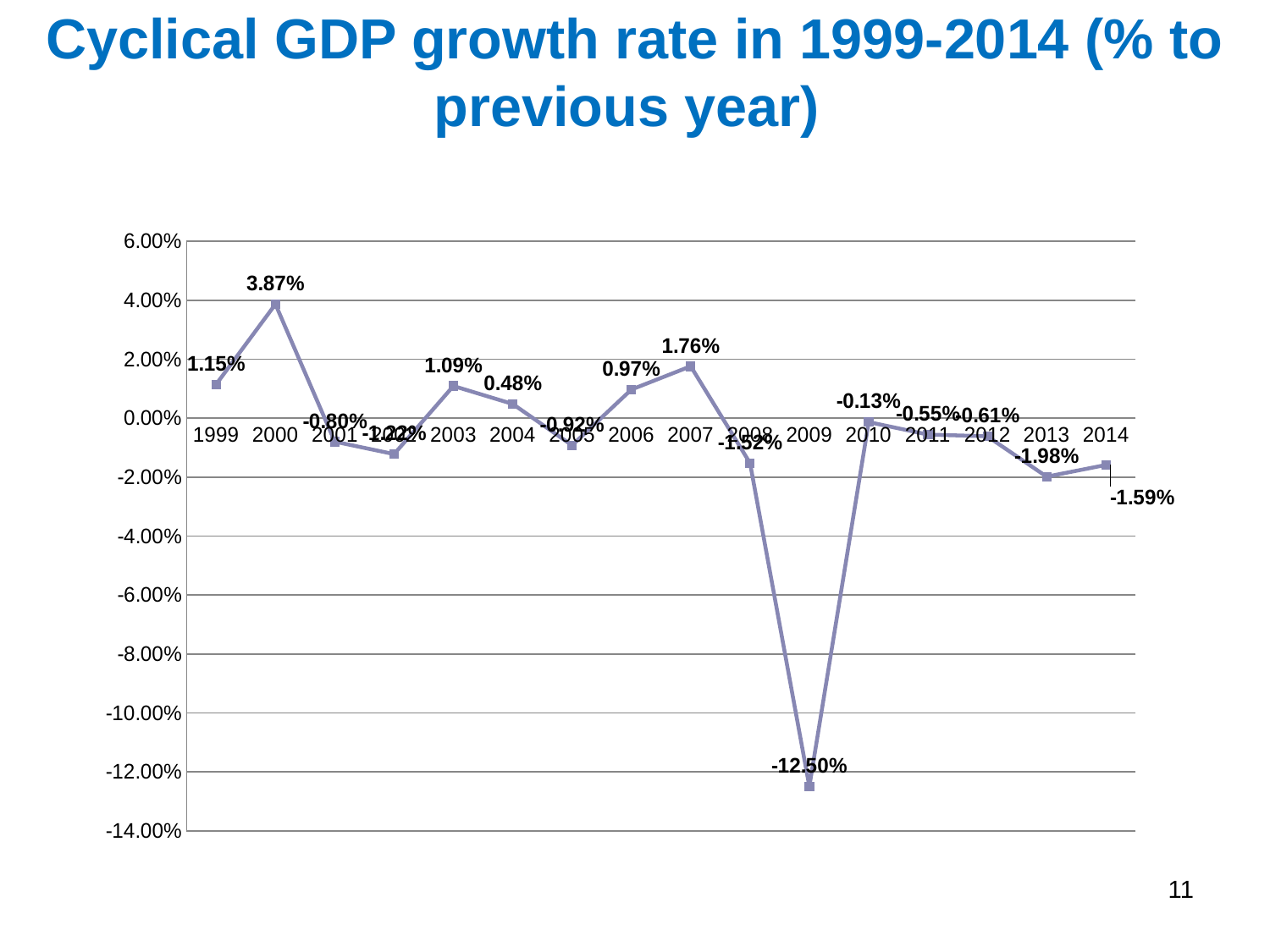
Is the value for 2009 greater or less than -10.00%? less Which year has the highest cyclical GDP growth rate? 2000 Which year has the lowest cyclical GDP growth rate? 2009 What is the cyclical GDP growth rate for 2007? 1.76% By how many percentage points does the 2000 value exceed the 1999 value? 2.72 percentage points What is the cyclical GDP growth rate for 2013? -1.98% Does the growth rate rise or fall from 2007 to 2009? Fall Which year has the larger growth rate, 2003 or 2006? 2003 What is the cyclical GDP growth rate for 2009? -12.50% How many years are plotted on the chart? 16 What kind of chart is shown on the slide? Line chart What is the cyclical GDP growth rate for 2000? 3.87%